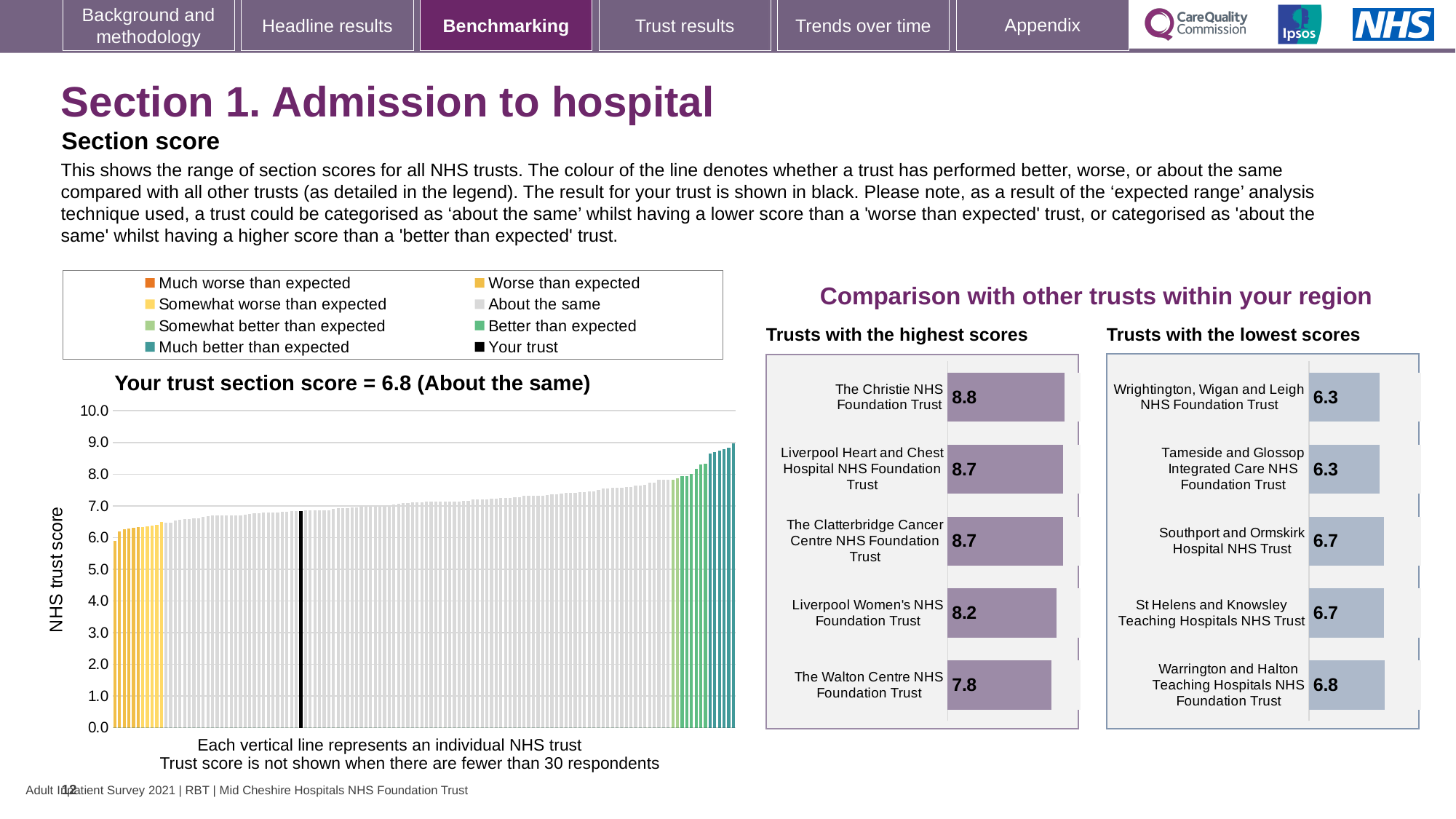
In the 'Trusts with the highest scores' chart, what is the score for The Christie NHS Foundation Trust? 8.8 In the 'Your trust section score' chart, is the value for your trust (the black bar) greater or less than 7.0? less In the 'Trusts with the lowest scores' chart, which trust has the highest score? Warrington and Halton Teaching Hospitals NHS Foundation Trust In the 'Your trust section score' chart, do the trust scores rise or fall from left to right? rise In the 'Trusts with the lowest scores' chart, which has the larger score: Wrightington, Wigan and Leigh NHS Foundation Trust or St Helens and Knowsley Teaching Hospitals NHS Trust? St Helens and Knowsley Teaching Hospitals NHS Trust In the 'Trusts with the highest scores' chart, which trust has the lowest score? The Walton Centre NHS Foundation Trust How many entries does the legend above the 'Your trust section score' chart list? 8 What kind of chart is the 'Your trust section score' chart? bar chart In the 'Your trust section score' chart, what is the section score for your trust? 6.8 In the 'Trusts with the lowest scores' chart, what is the score for Southport and Ormskirk Hospital NHS Trust? 6.7 In the 'Trusts with the highest scores' chart, what is the difference between the scores of The Christie NHS Foundation Trust and The Walton Centre NHS Foundation Trust? 1.0 How many trusts are shown in the 'Trusts with the highest scores' chart? 5